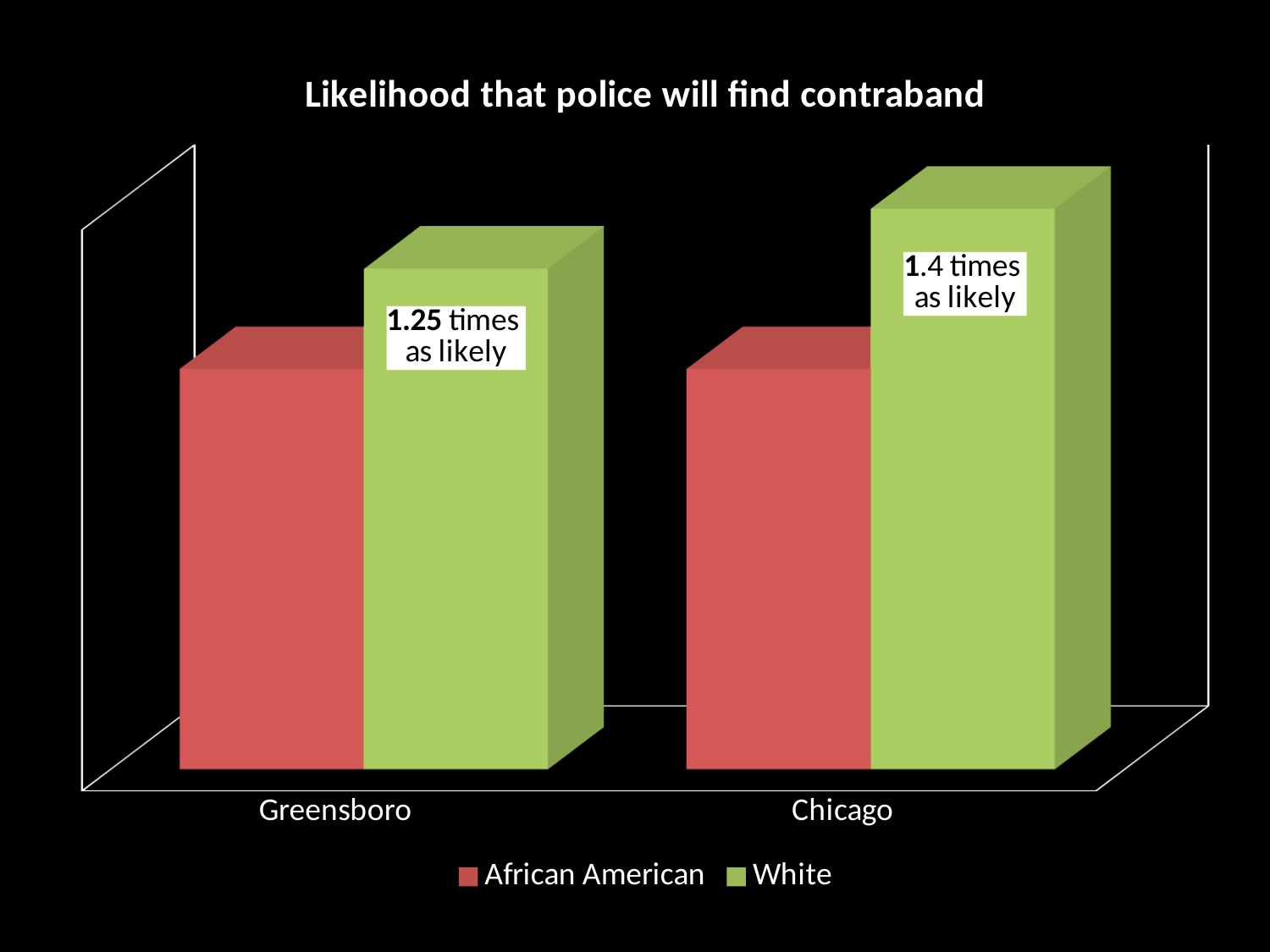
In which city is the White bar lower? Greensboro How many series does the legend list? 2 What kind of chart is shown on the slide? Bar chart What is the difference between the White value in Chicago and the White value in Greensboro? 0.15 What is the labelled value for White in Greensboro? 1.25 times as likely In Chicago, which bar is taller: African American or White? White What is the title of the chart? Likelihood that police will find contraband In Greensboro, which bar is taller: African American or White? White In which city is the White bar higher? Chicago Which is larger: the White value in Chicago or the White value in Greensboro? Chicago What is the labelled value for White in Chicago? 1.4 times as likely How many cities are shown on the x axis? 2